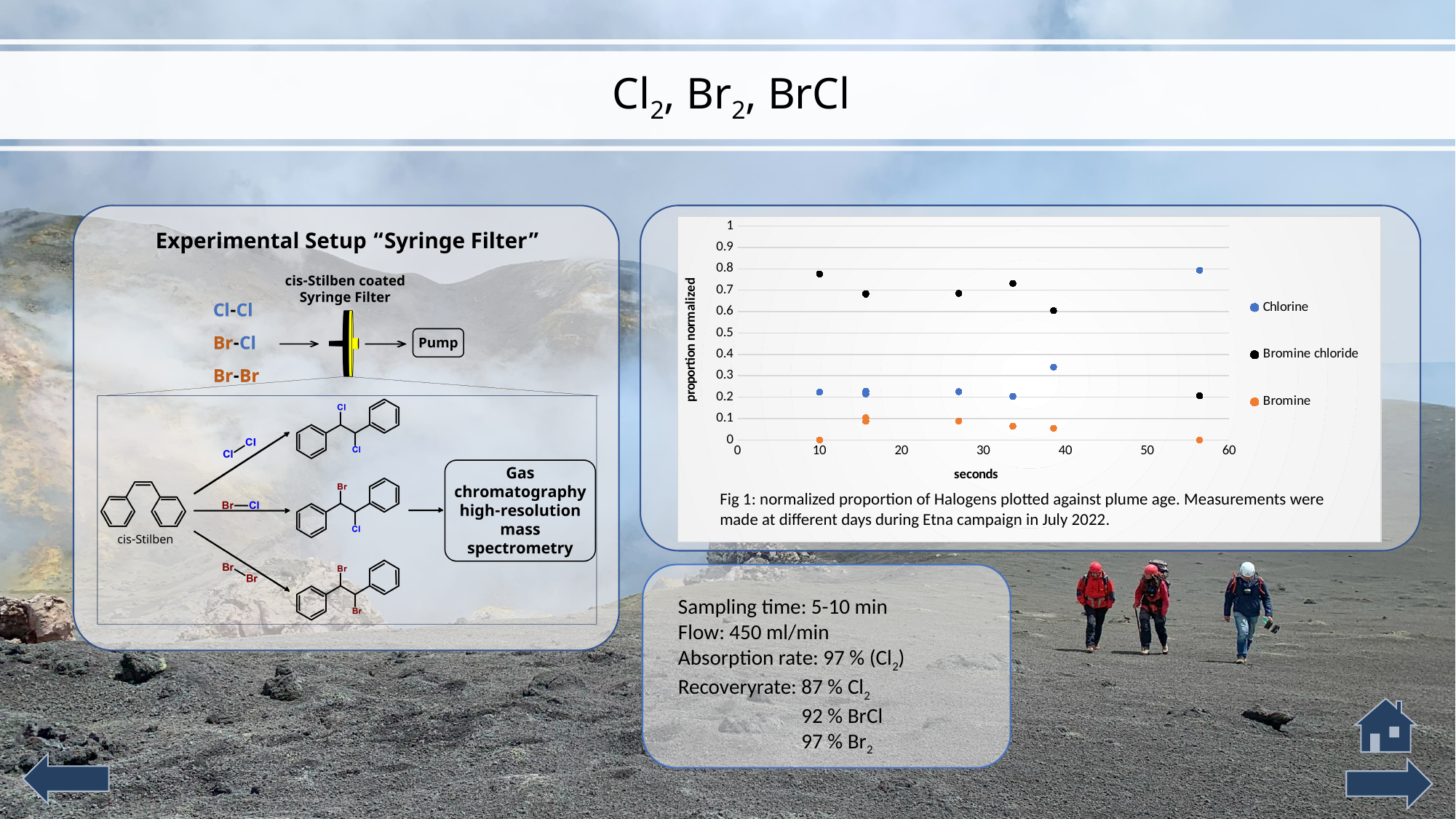
What is the label of the y axis of the chart? proportion normalized At about 56 seconds, which series has the larger value, Chlorine or Bromine chloride? Chlorine Is the Chlorine value at about 38 seconds greater or less than 0.3? greater Is the Bromine chloride value at about 10 seconds greater or less than 0.7? greater Do the Bromine chloride values overall rise or fall as seconds increase? fall What is the label of the x axis of the chart? seconds Are all the Bromine values greater or less than 0.2? less How many series does the chart legend list? 3 What kind of chart is shown on the slide? scatter chart At about 10 seconds, which series has the larger value, Chlorine or Bromine chloride? Bromine chloride